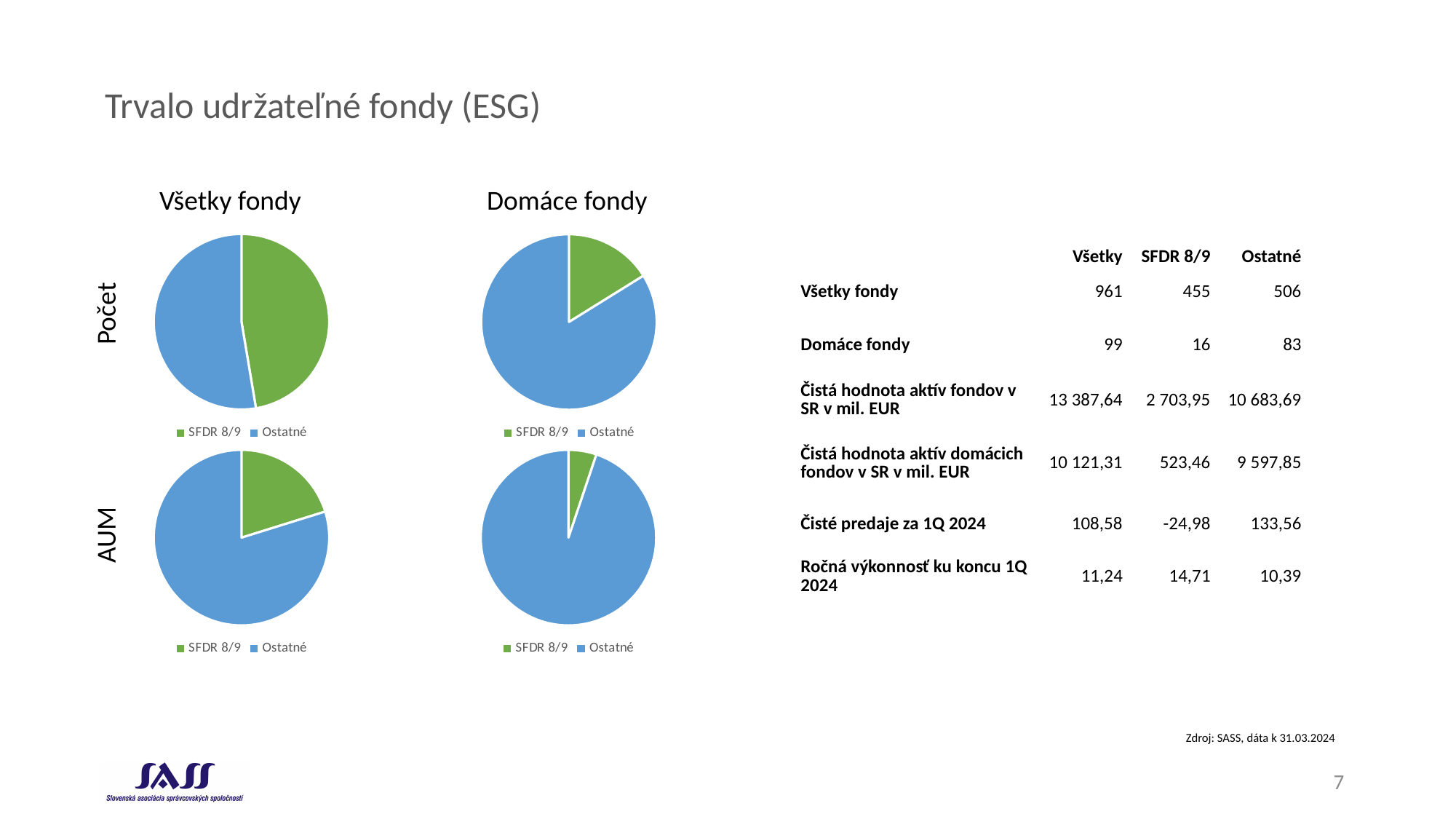
How many entries does the legend of the Všetky fondy AUM pie chart list? 2 What kind of chart is used for the Všetky fondy Počet chart? Pie chart In the Všetky fondy AUM pie chart, which slice is the largest? Ostatné In the Domáce fondy AUM pie chart, which slice is the smallest? SFDR 8/9 How many pie charts are shown on the slide? 4 What colour represents SFDR 8/9 in the pie charts? Green In the Všetky fondy Počet pie chart, which slice is the smallest? SFDR 8/9 What are the two row labels on the left of the pie charts? Počet and AUM In the Domáce fondy AUM pie chart, is the SFDR 8/9 slice larger or smaller than the Ostatné slice? Smaller How many slices does the Domáce fondy Počet pie chart have? 2 In the Domáce fondy Počet pie chart, which slice is larger, SFDR 8/9 or Ostatné? Ostatné